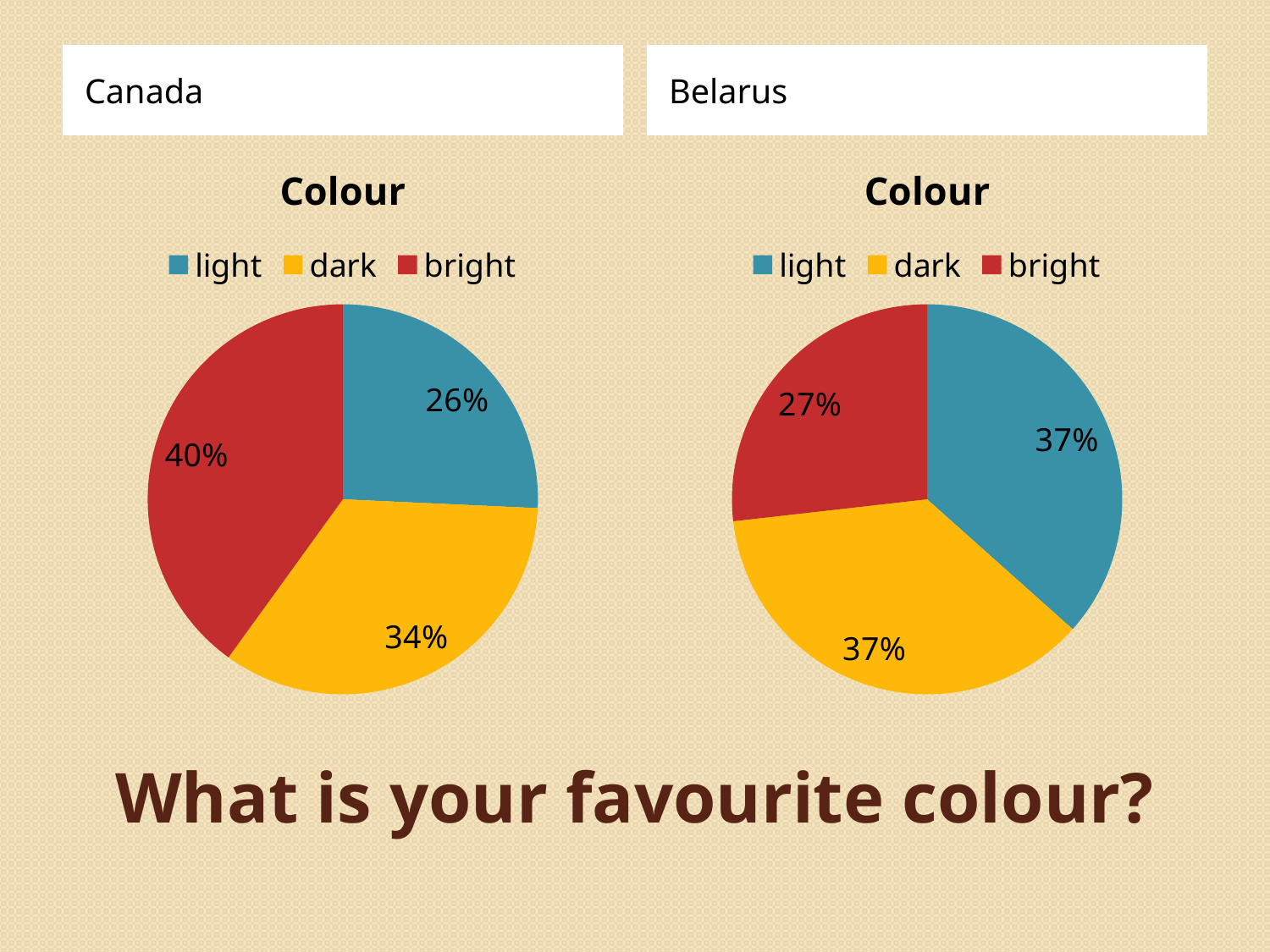
In the Belarus pie chart, which colour category has the smallest slice? bright Which is larger: the 'dark' share in the Canada chart or the 'dark' share in the Belarus chart? Belarus In the Canada pie chart, what share of the pie is the 'bright' slice? 40% In the Canada pie chart, which colour category has the smallest slice? light What type of chart is used for Canada? pie chart In the Belarus pie chart, what share of the pie is the 'bright' slice? 27% In the Canada pie chart, what is the difference between the 'bright' and 'light' shares? 14% In the Belarus pie chart, what is the difference between the 'light' and 'bright' shares? 10% In the Belarus pie chart, what share of the pie is the 'dark' slice? 37% How many slices does the Belarus pie chart have? 3 In the Canada pie chart, which colour category has the largest slice? bright